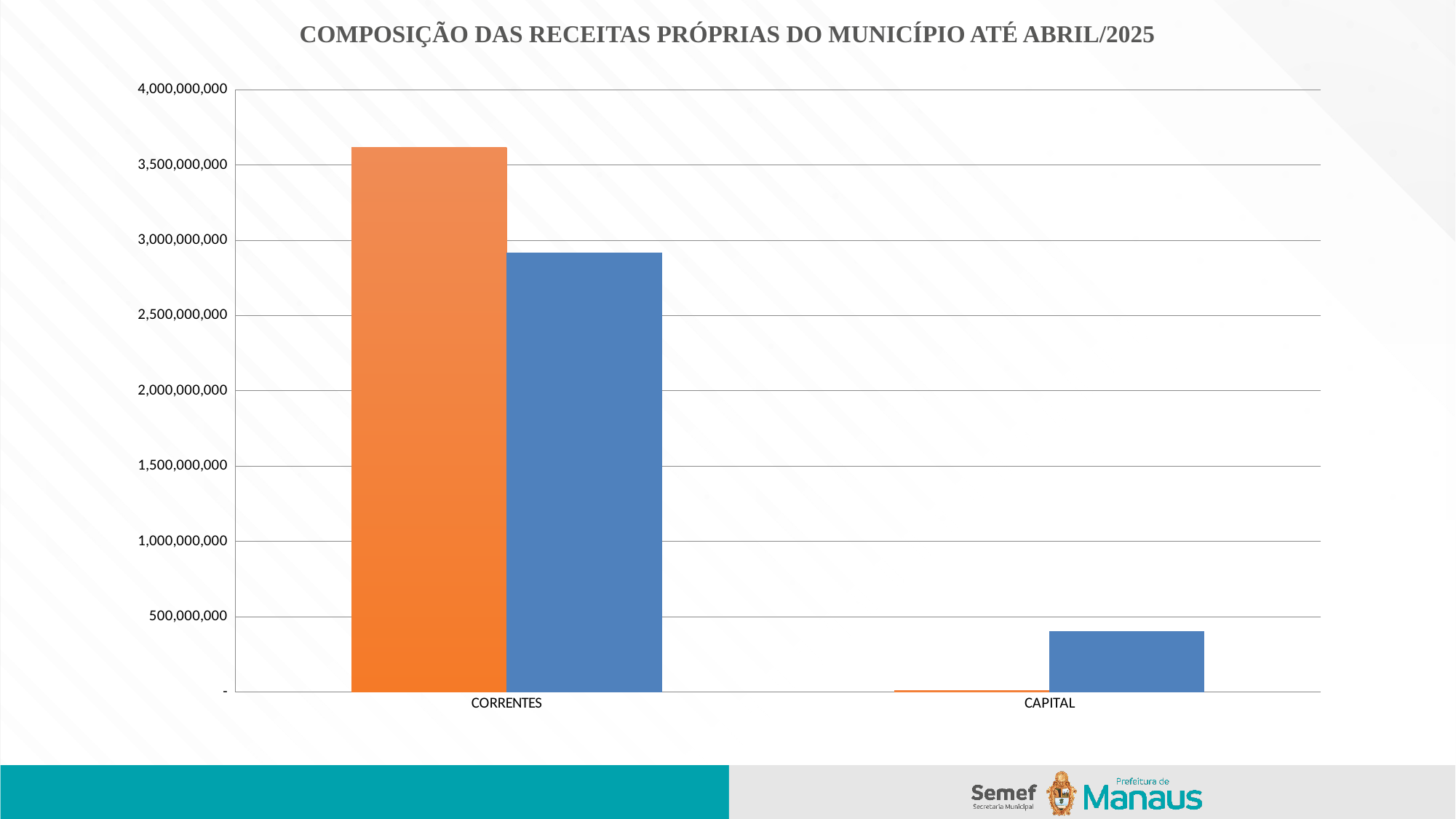
For CAPITAL, which bar is taller, the orange one or the blue one? The blue one For CORRENTES, which bar is taller, the orange one or the blue one? The orange one How many categories are shown on the x axis? 2 What is the title of the chart? COMPOSIÇÃO DAS RECEITAS PRÓPRIAS DO MUNICÍPIO ATÉ ABRIL/2025 Which category has the shortest bar? CAPITAL Is the value of the orange bar for CORRENTES greater or less than 3,500,000,000? greater Is the value of the orange bar for CAPITAL greater or less than 500,000,000? less Is the value of the blue bar for CAPITAL greater or less than 500,000,000? less Which category has the tallest bar? CORRENTES Do the values rise or fall from CORRENTES to CAPITAL? Fall What kind of chart is shown on the slide? Bar chart